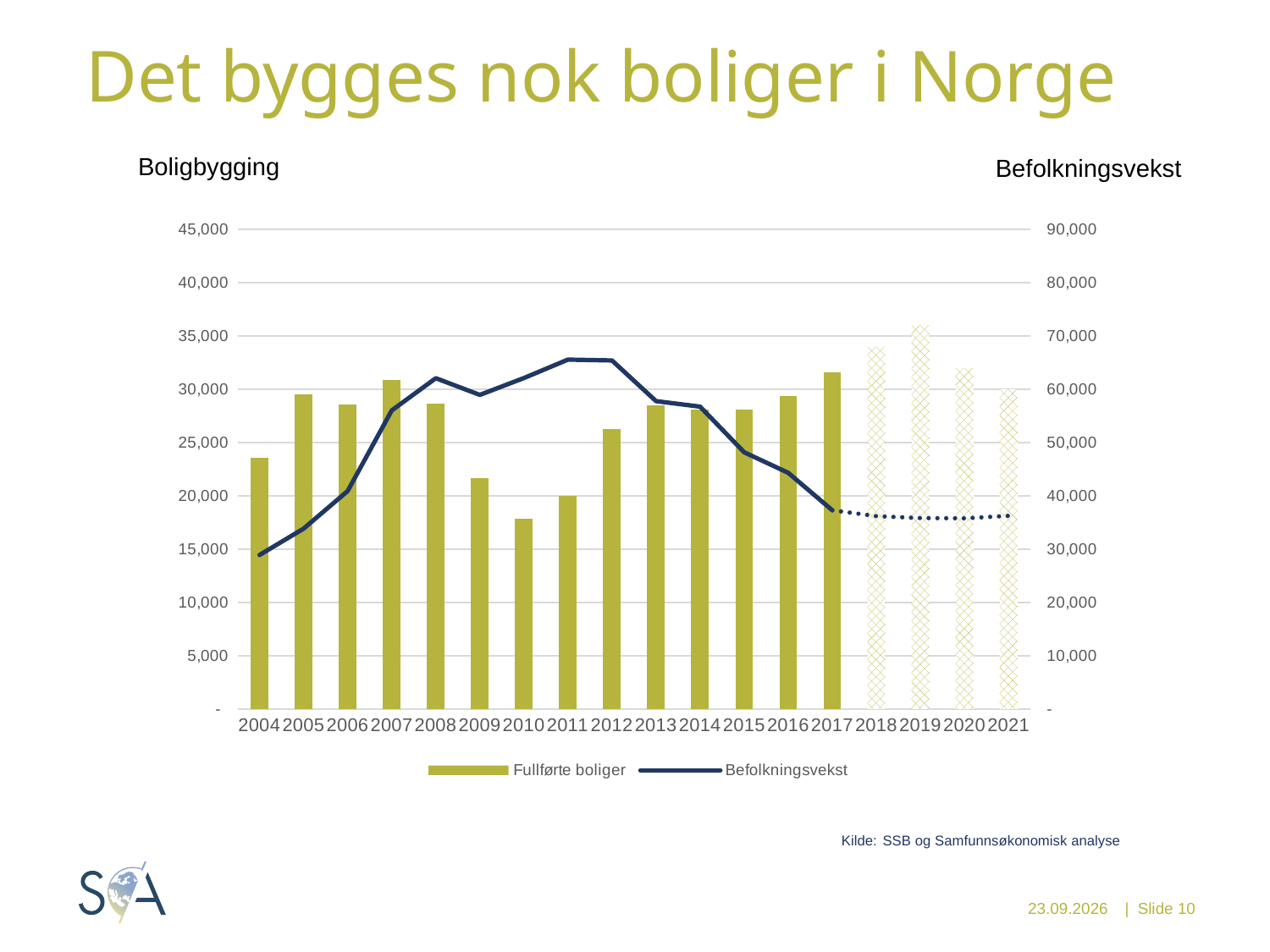
Which year has the larger Fullførte boliger bar, 2007 or 2009? 2007 What are the two entries in the chart legend? Fullførte boliger and Befolkningsvekst What kind of chart is shown on the slide? A combined bar and line chart Is the Fullførte boliger value for 2004 greater or less than 25,000? less Which year has the lowest bar for Fullførte boliger? 2010 Is the Befolkningsvekst value for 2011 greater or less than 60,000 on the right axis? greater Does the Befolkningsvekst line rise or fall between 2012 and 2017? It falls Do the Fullførte boliger bars rise or fall from 2008 to 2010? They fall What label is shown above the right-hand axis of the chart? Befolkningsvekst How many years are shown along the x axis? 18 Is the Fullførte boliger value for 2010 greater or less than 20,000? less How many series does the legend list? 2